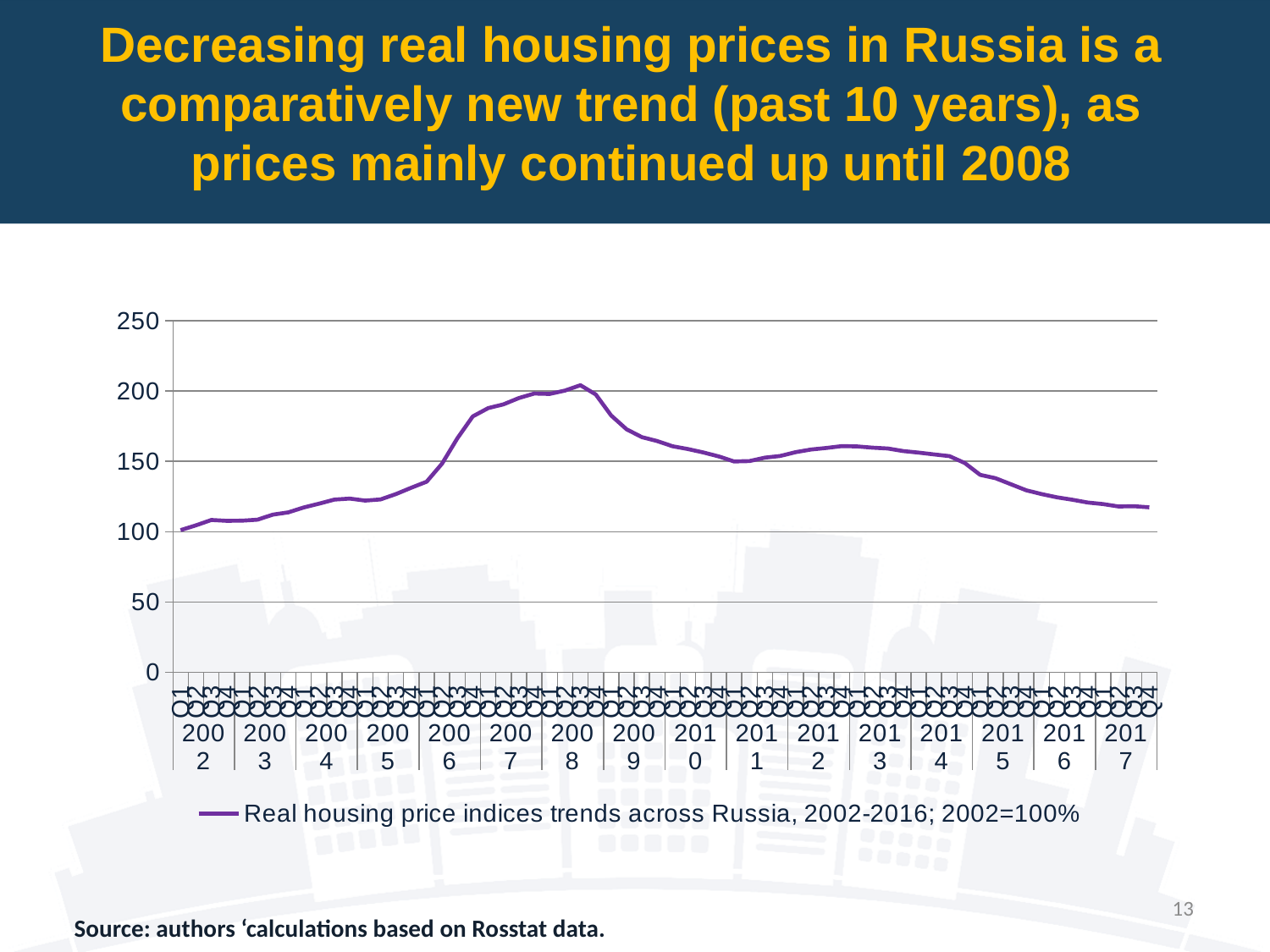
Is the peak value in 2008 greater or less than 150? greater In which year does the real housing price index reach its highest point? 2008 Are the values in 2012 greater or less than 150? greater What is the legend entry for the plotted series? Real housing price indices trends across Russia, 2002-2016; 2002=100% Is the value at the end of 2017 greater or less than 150? less How many years are labelled along the x axis? 16 Which is higher, the index in 2008 or the index in 2017? 2008 How many series does the legend list? 1 In which year is the real housing price index at its lowest? 2002 What kind of chart is shown on the slide? line chart Does the index rise or fall between 2002 and 2008? rise